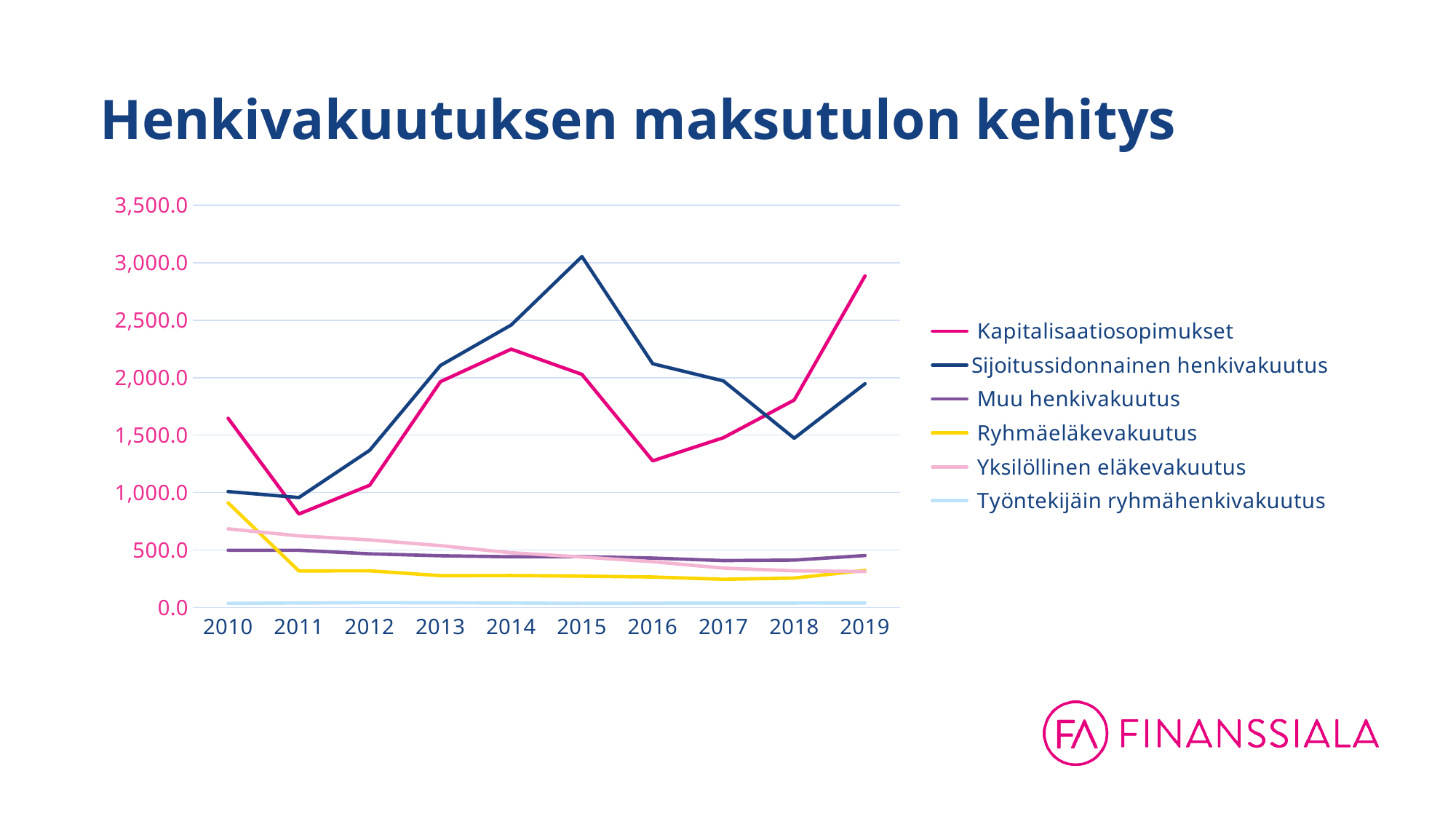
How many years are shown on the x axis? 10 Does Yksilöllinen eläkevakuutus rise or fall from 2010 to 2018? Fall What is the title of the chart? Henkivakuutuksen maksutulon kehitys In 2010, which is higher: Ryhmäeläkevakuutus or Yksilöllinen eläkevakuutus? Ryhmäeläkevakuutus In 2019, which is higher: Kapitalisaatiosopimukset or Sijoitussidonnainen henkivakuutus? Kapitalisaatiosopimukset How many series does the legend list? 6 Is the value for Kapitalisaatiosopimukset in 2016 greater or less than 1,500.0? less Is the value for Sijoitussidonnainen henkivakuutus in 2015 greater or less than 3,000.0? greater In which year does Kapitalisaatiosopimukset reach its highest value? 2019 In which year is Kapitalisaatiosopimukset at its lowest? 2011 What kind of chart is shown on the slide? Line chart In which year does Sijoitussidonnainen henkivakuutus reach its highest value? 2015